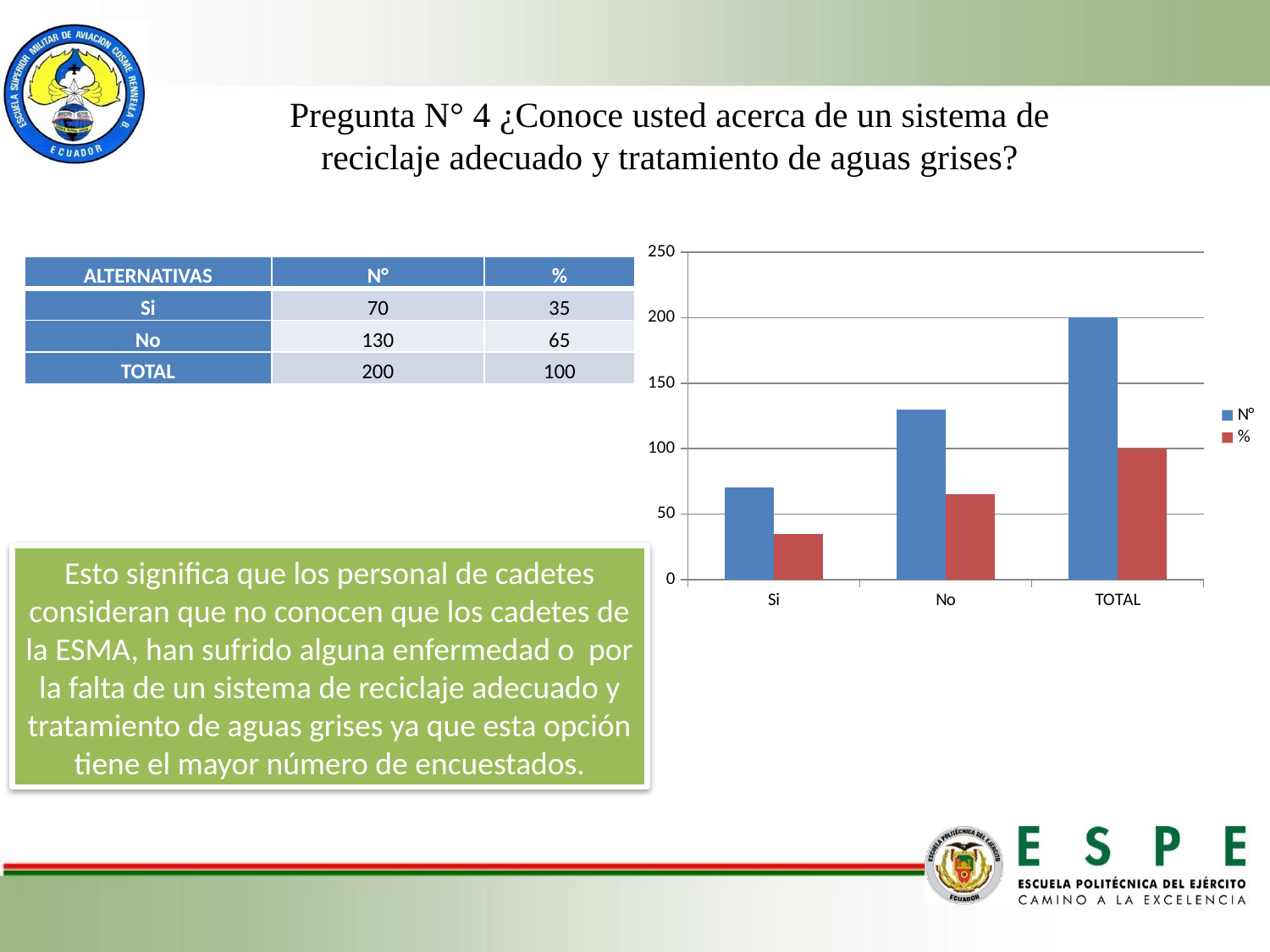
What is the % value for Si? 35 Is the N° value for Si greater or less than 100? less What type of chart is shown on the slide? bar chart Which is larger, the N° value for No or the N° value for Si? No What is the difference between the N° values for No and Si? 60 What is the % value for TOTAL in the chart? 100 What is the N° value for No? 130 Which category has the lowest N° value? Si What is the N° value for TOTAL in the chart? 200 Is the % value for No greater or less than 50? greater How many categories are shown on the x axis of the chart? 3 How many series does the chart legend list? 2